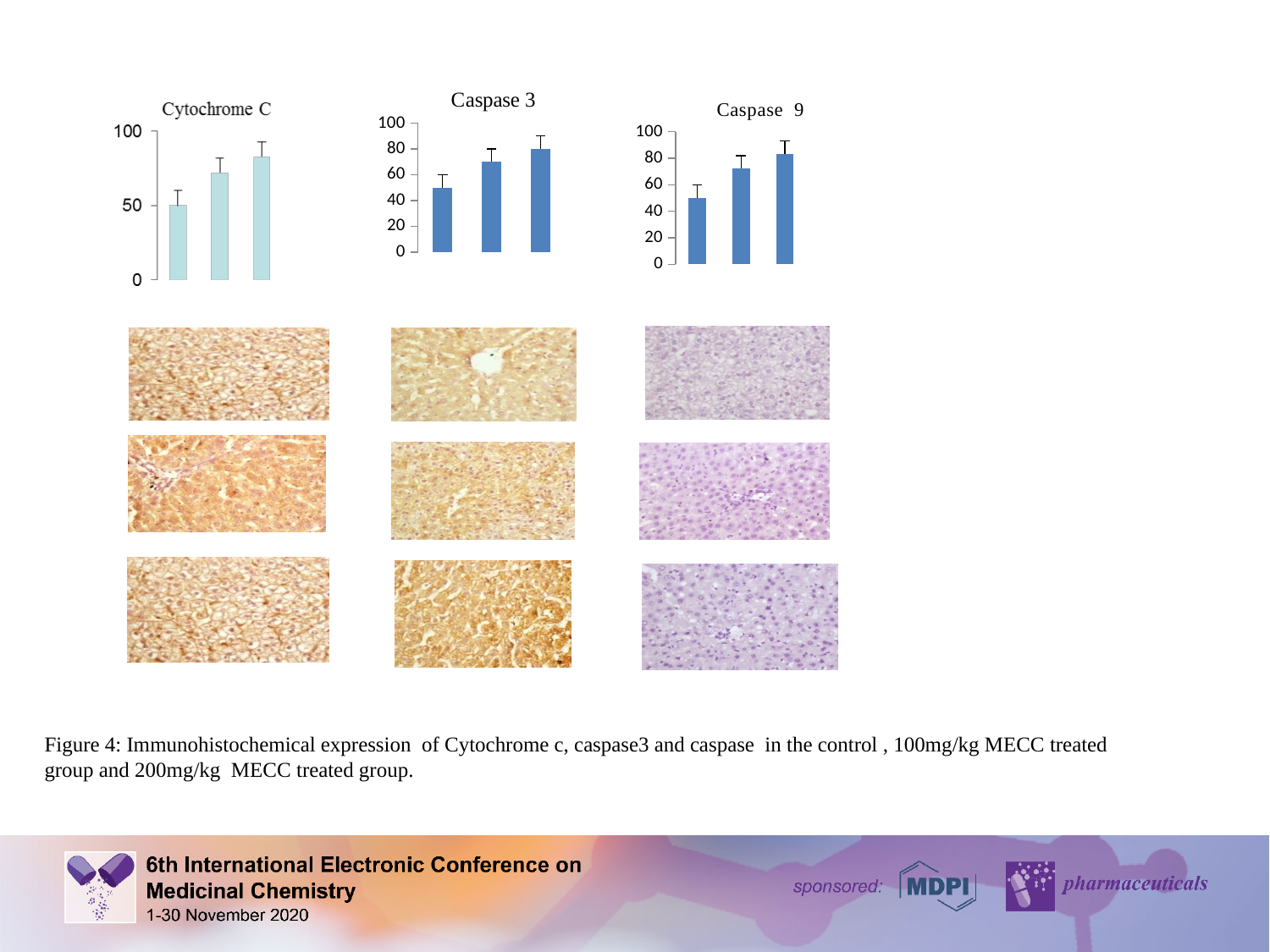
How many bar charts are shown on the slide? 3 In the Caspase 3 chart, is the value of the first (leftmost) bar greater or less than 60? less In the Cytochrome C chart, which is larger: the first (leftmost) bar or the third (rightmost) bar? the third (rightmost) bar What kind of chart is the Cytochrome C chart? bar chart What is the highest tick value shown on the y axis of the Caspase 3 chart? 100 In the Caspase 9 chart, which bar is the lowest? the first (leftmost) bar In the Caspase 9 chart, is the value of the third (rightmost) bar greater or less than 60? greater In the Caspase 3 chart, which bar is the highest? the third (rightmost) bar In the Cytochrome C chart, do the bar values rise or fall from left to right? rise In the Caspase 3 chart, how many bars are plotted? 3 In the Caspase 9 chart, how many bars are plotted? 3 In the Cytochrome C chart, is the value of the second (middle) bar greater or less than 50? greater